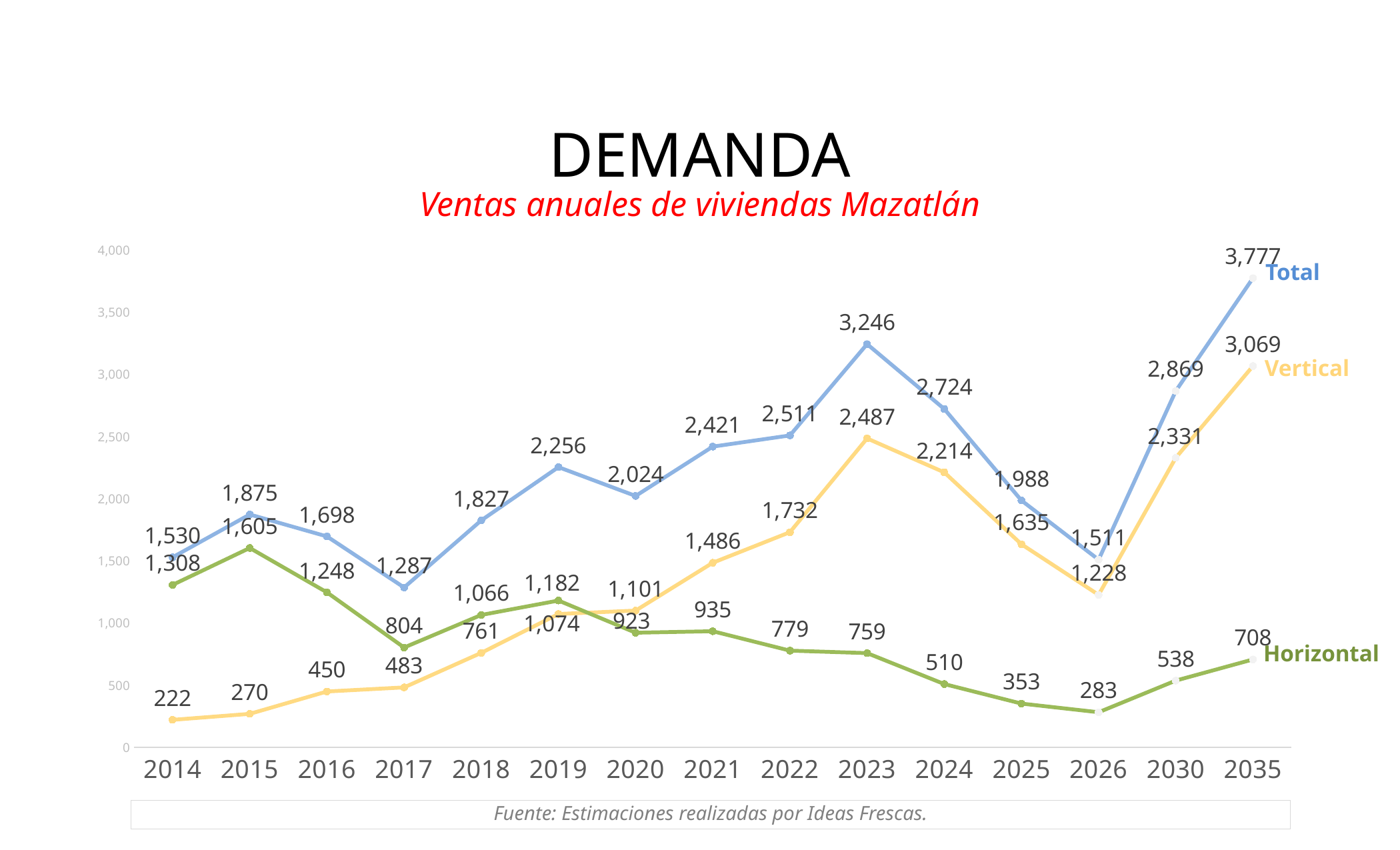
In which year is the Vertical series lowest? 2014 How many years are plotted along the x axis? 15 What is the Horizontal value for 2026? 283 What is the Total value for 2023? 3,246 What type of chart is shown on the slide? Line chart Does the Horizontal series rise or fall from 2021 to 2026? Fall What is the Vertical value for 2019? 1,074 In which year is the Total series highest? 2035 What is the difference between the Total values for 2035 and 2023? 531 What is the subtitle shown in red below the title DEMANDA? Ventas anuales de viviendas Mazatlán Which is larger in 2020, the Vertical value or the Horizontal value? Vertical How many series does the chart show? 3